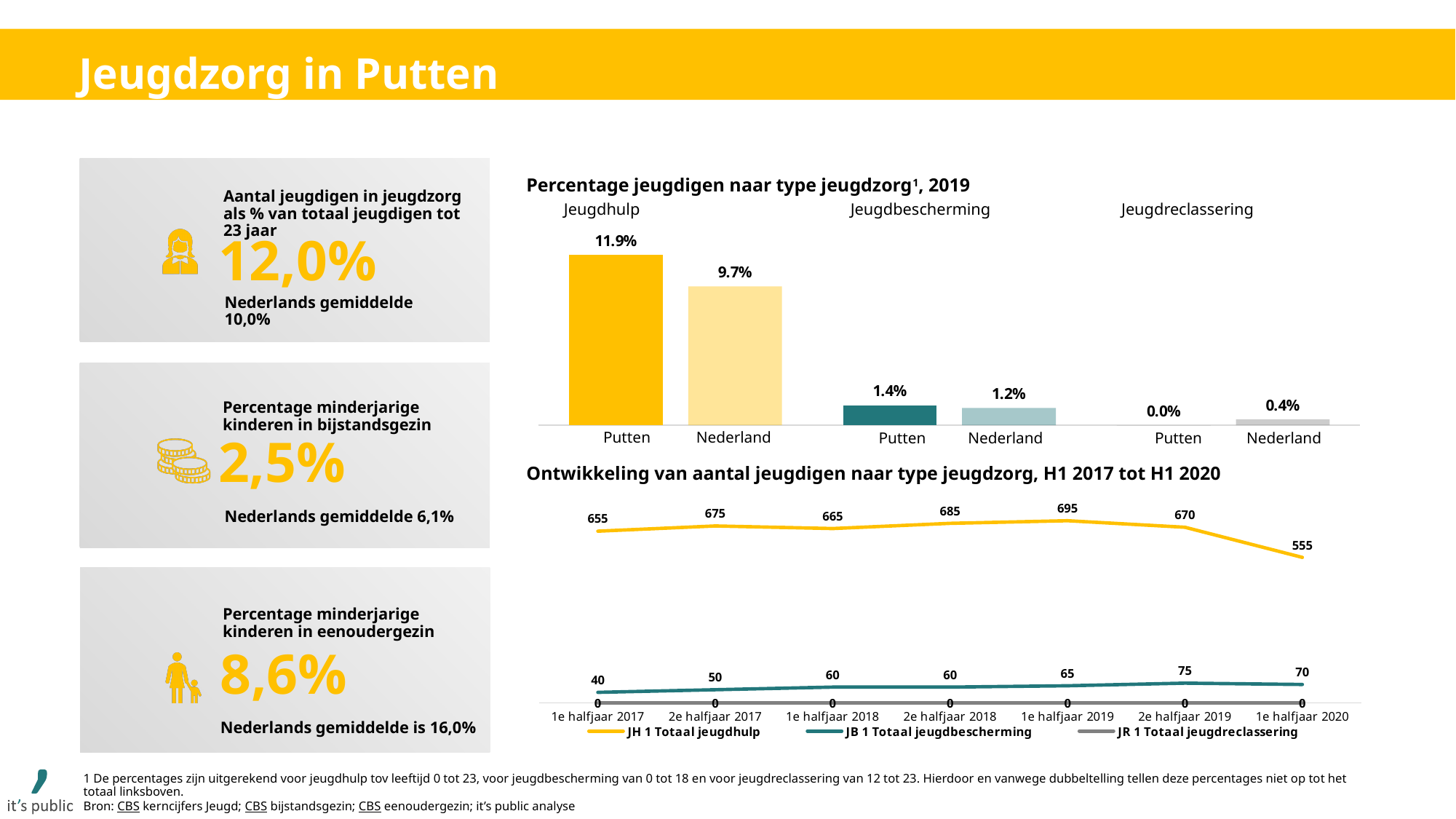
In the chart 'Ontwikkeling van aantal jeugdigen naar type jeugdzorg, H1 2017 tot H1 2020', by how much did JH 1 Totaal jeugdhulp fall from 2e halfjaar 2019 to 1e halfjaar 2020? 115 In the chart 'Ontwikkeling van aantal jeugdigen naar type jeugdzorg, H1 2017 tot H1 2020', what is the value of JB 1 Totaal jeugdbescherming in 2e halfjaar 2019? 75 In the chart 'Percentage jeugdigen naar type jeugdzorg, 2019', what is the Jeugdbescherming percentage for Nederland? 1.2% In the chart 'Ontwikkeling van aantal jeugdigen naar type jeugdzorg, H1 2017 tot H1 2020', in which period does JH 1 Totaal jeugdhulp reach its highest value? 1e halfjaar 2019 In the chart 'Percentage jeugdigen naar type jeugdzorg, 2019', what is the difference between the Jeugdhulp percentages for Putten and Nederland? 2.2% In the chart 'Percentage jeugdigen naar type jeugdzorg, 2019', which bar is the highest? Jeugdhulp Putten In the chart 'Percentage jeugdigen naar type jeugdzorg, 2019', is the Jeugdreclassering value larger for Putten or for Nederland? Nederland In the chart 'Ontwikkeling van aantal jeugdigen naar type jeugdzorg, H1 2017 tot H1 2020', how many series does the legend list? 3 In the chart 'Ontwikkeling van aantal jeugdigen naar type jeugdzorg, H1 2017 tot H1 2020', how many time periods are shown on the x axis? 7 In the chart 'Ontwikkeling van aantal jeugdigen naar type jeugdzorg, H1 2017 tot H1 2020', what is the value of JH 1 Totaal jeugdhulp in 1e halfjaar 2020? 555 What kind of chart is 'Percentage jeugdigen naar type jeugdzorg, 2019'? Bar chart In the chart 'Percentage jeugdigen naar type jeugdzorg, 2019', what is the Jeugdhulp percentage for Putten? 11.9%